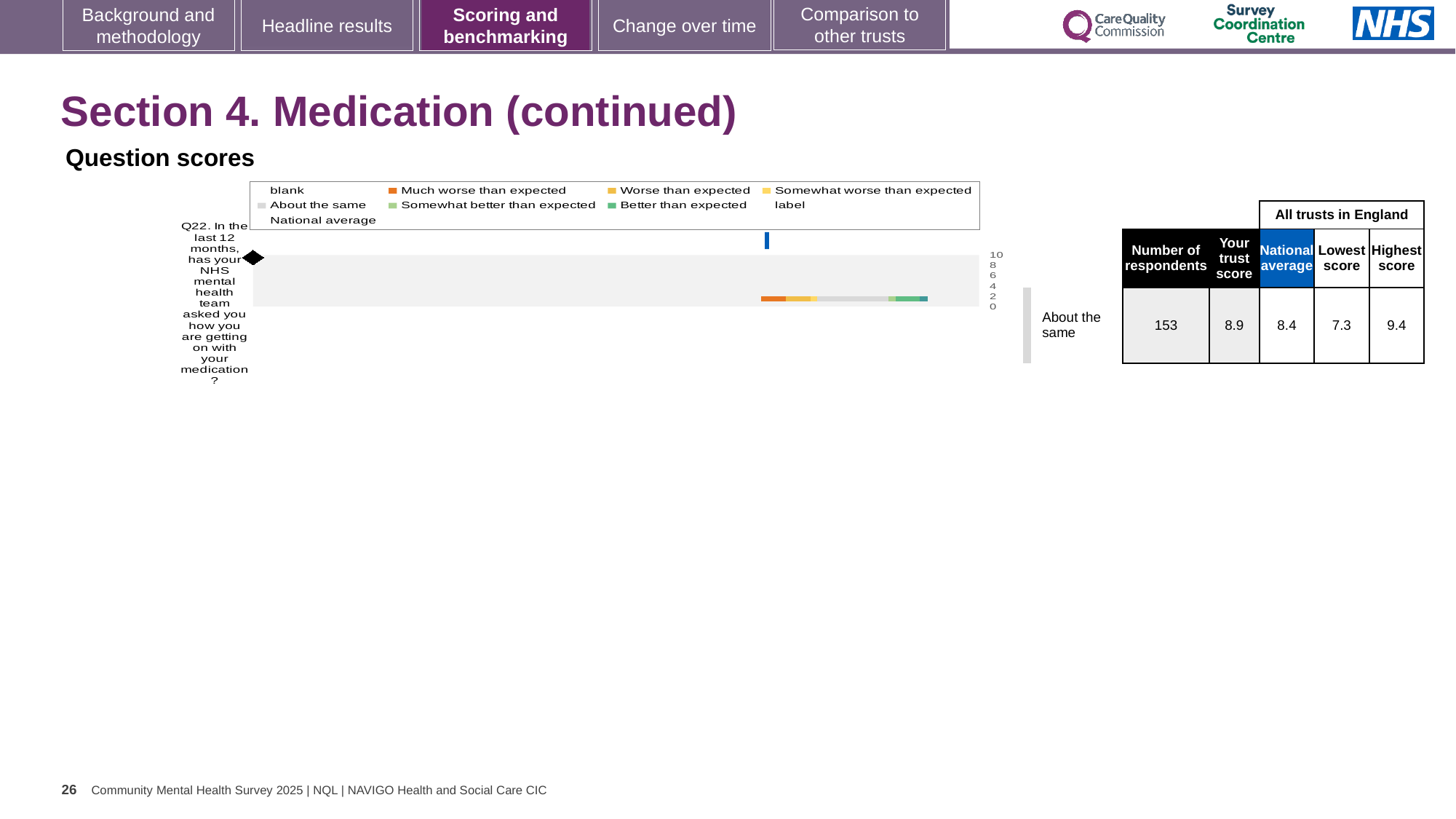
What is the maximum value shown on the chart's score axis? 10 Which is larger for Q22, the trust score or the national average? the trust score What is the difference between the highest and lowest scores among all trusts in England for Q22? 2.1 What is the highest score among all trusts in England for Q22? 9.4 What is the trust score for Q22 shown on the slide? 8.9 Which benchmarking category is Q22 placed in? About the same How many respondents answered Q22? 153 How many questions are plotted on the chart? 1 What is the lowest score among all trusts in England for Q22? 7.3 What kind of chart is used to show the Q22 question score? bar chart What is the national average score for Q22? 8.4 What is the difference between the trust score and the national average for Q22? 0.5